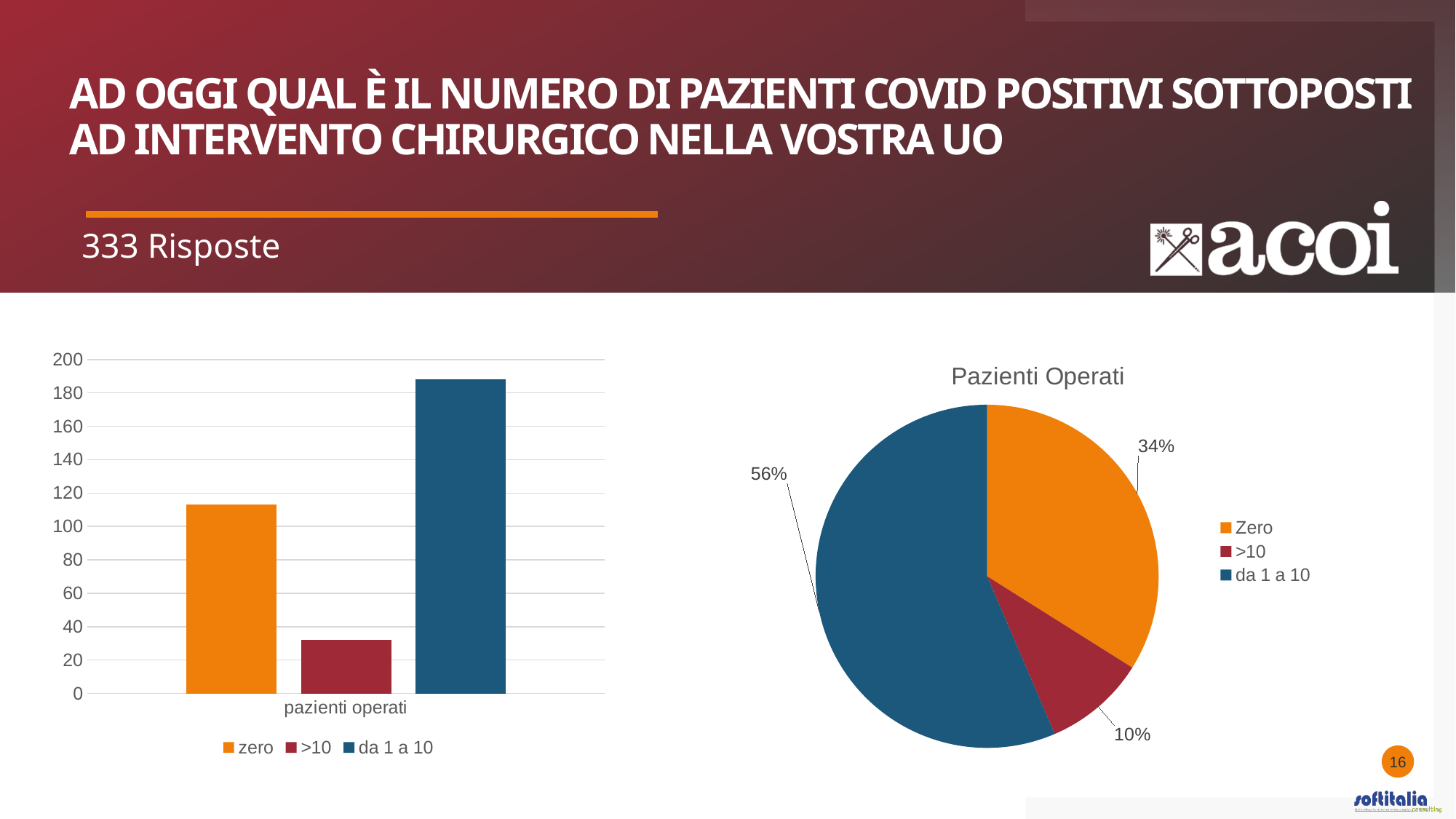
What kind of chart is the chart titled 'Pazienti Operati'? pie chart What kind of chart is the chart on the left of the slide? bar chart In the bar chart on the left, is the value for 'zero' greater or less than 100? greater In the bar chart on the left, which series has the shortest bar? >10 In the pie chart 'Pazienti Operati', what is the difference between the 'Zero' share and the '>10' share? 24% In the pie chart 'Pazienti Operati', what share does the '>10' slice have? 10% In the bar chart on the left, is the value for 'da 1 a 10' greater or less than 180? greater How many series does the legend of the bar chart on the left list? 3 In the bar chart on the left, which series has the tallest bar? da 1 a 10 In the bar chart on the left, which is larger, the value for 'zero' or the value for '>10'? zero In the pie chart 'Pazienti Operati', what share does the 'da 1 a 10' slice have? 56% In the bar chart on the left, is the value for '>10' greater or less than 40? less